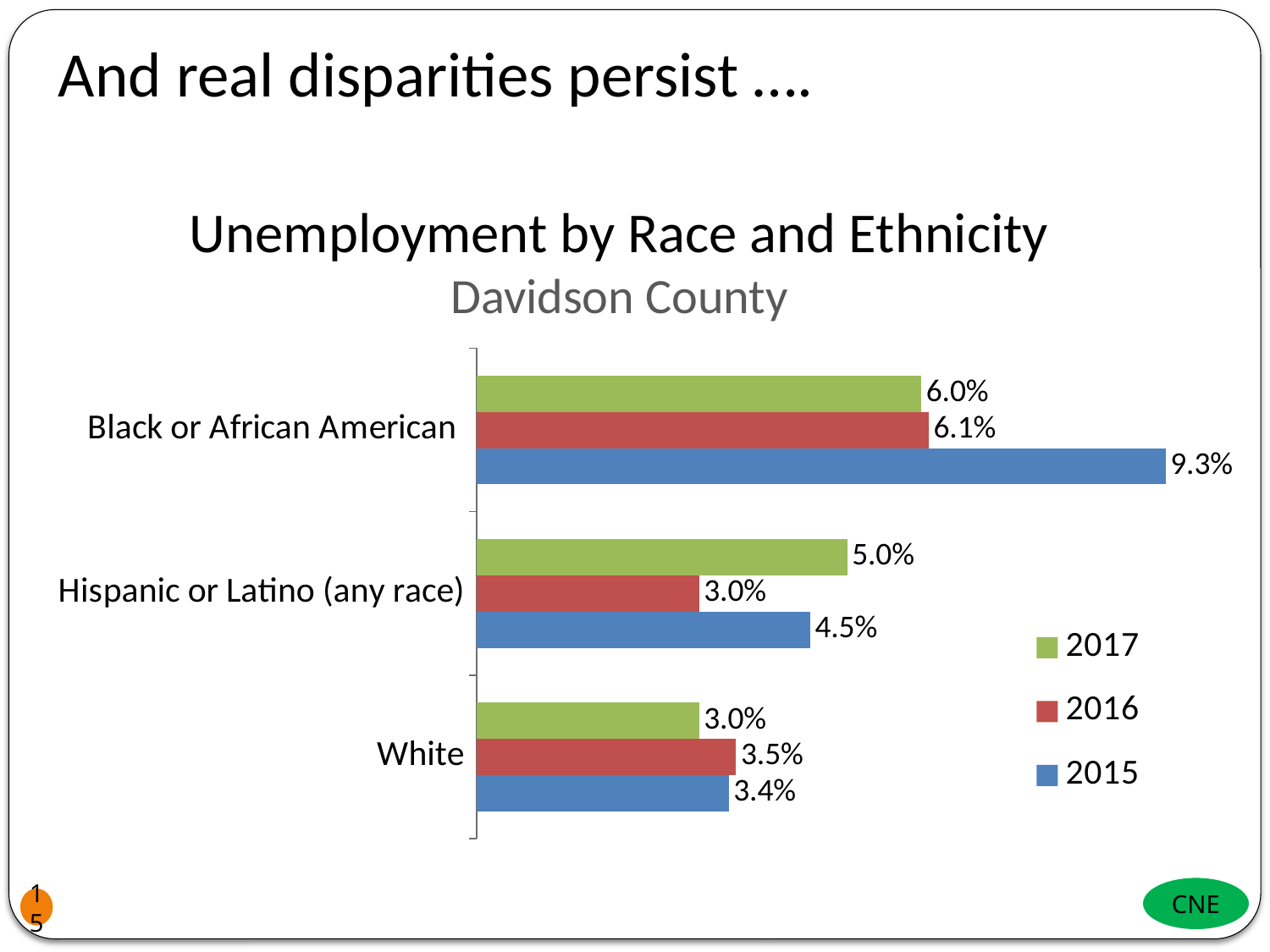
What is the difference between the 2017 and 2016 unemployment rates for Hispanic or Latino (any race)? 2.0% Which category has the lowest 2017 unemployment rate? White Which category has the highest 2015 unemployment rate? Black or African American What is the difference between the 2015 and 2017 unemployment rates for Black or African American? 3.3% How many race/ethnicity categories are shown in the chart? 3 Which is larger for White: the 2016 rate or the 2017 rate? 2016 What is the 2015 unemployment rate for Black or African American? 9.3% What is the subtitle of the chart? Davidson County What kind of chart is shown on the slide? Bar chart How many series does the legend list? 3 What is the 2017 unemployment rate for Hispanic or Latino (any race)? 5.0% What is the 2016 unemployment rate for White? 3.5%